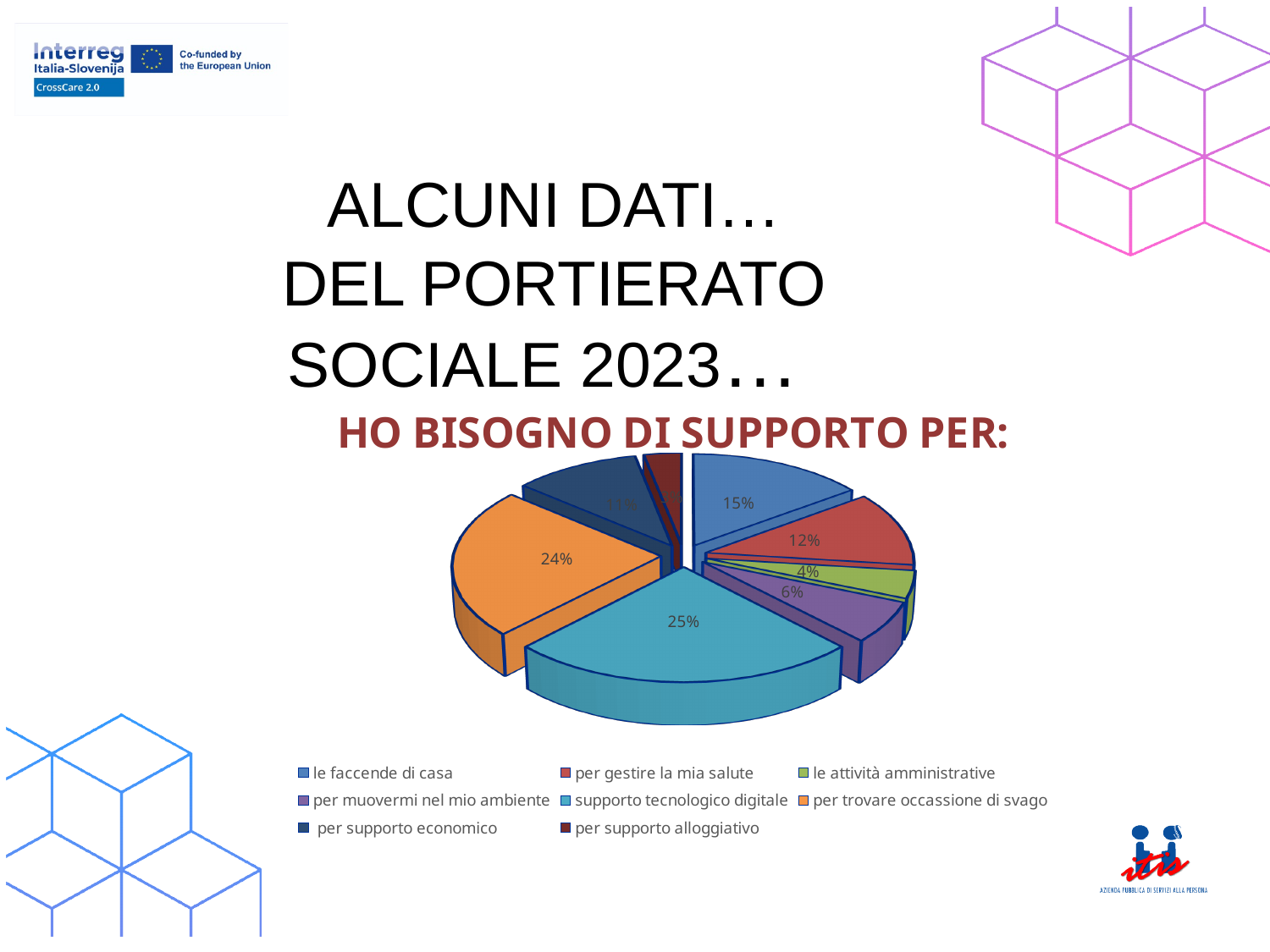
Which category has the smallest share of the pie? per supporto alloggiativo What is the difference in percentage points between 'le faccende di casa' and 'per muovermi nel mio ambiente'? 9 What percentage of the pie is 'per trovare occassione di svago'? 24% What percentage of the pie is 'le faccende di casa'? 15% What percentage of the pie is 'per gestire la mia salute'? 12% What percentage of the pie is 'le attività amministrative'? 4% How many categories does the legend of the pie chart list? 8 Which category has the largest share of the pie? supporto tecnologico digitale What percentage of the pie is 'per supporto economico'? 11% What is the title of the chart? HO BISOGNO DI SUPPORTO PER: What percentage of the pie is 'supporto tecnologico digitale'? 25% What kind of chart is shown on the slide? pie chart